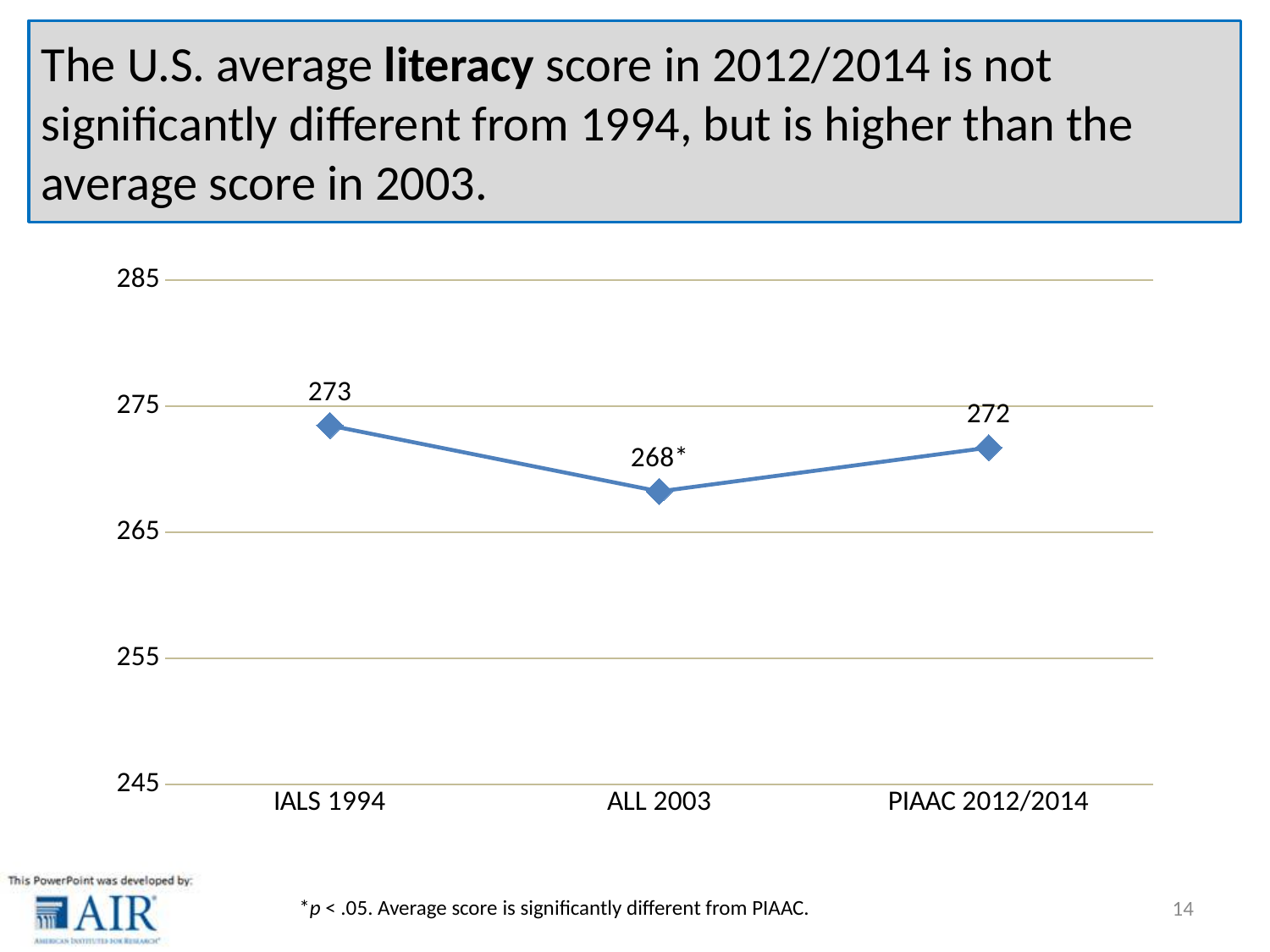
Which data point is marked with an asterisk? ALL 2003 How many data points are plotted on the chart? 3 What kind of chart is shown on the slide? line chart What is the U.S. average literacy score for IALS 1994? 273 Which assessment has the highest average literacy score? IALS 1994 What is the U.S. average literacy score for ALL 2003? 268 Which assessment has the lowest average literacy score? ALL 2003 What is the difference between the PIAAC 2012/2014 score and the ALL 2003 score? 4 What is the difference between the IALS 1994 score and the ALL 2003 score? 5 Is the value for ALL 2003 greater or less than 275? less What is the U.S. average literacy score for PIAAC 2012/2014? 272 Which is larger, the score for ALL 2003 or the score for PIAAC 2012/2014? PIAAC 2012/2014